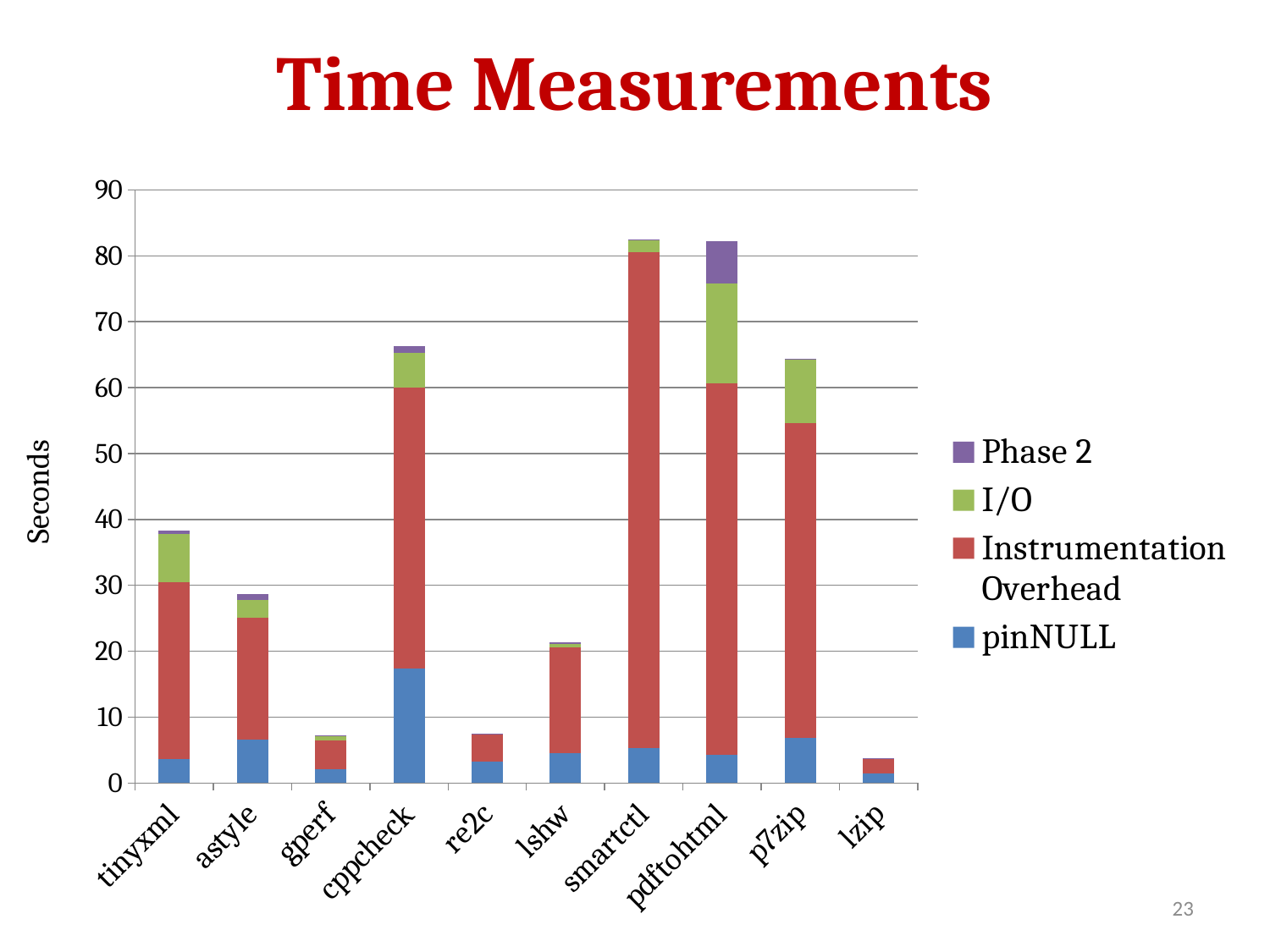
Is the total value for cppcheck greater or less than 60? greater Is the total value for tinyxml greater or less than 40? less Which has a larger total time, cppcheck or tinyxml? cppcheck Is the total value for p7zip greater or less than 60? greater What kind of chart is shown on the slide? Stacked bar chart How many series does the legend list? 4 What is the label on the y axis? Seconds Which program has the largest pinNULL segment? cppcheck Which program has the lowest total time? lzip How many programs (categories) are shown on the x axis? 10 Which has a larger total time, pdftohtml or p7zip? pdftohtml